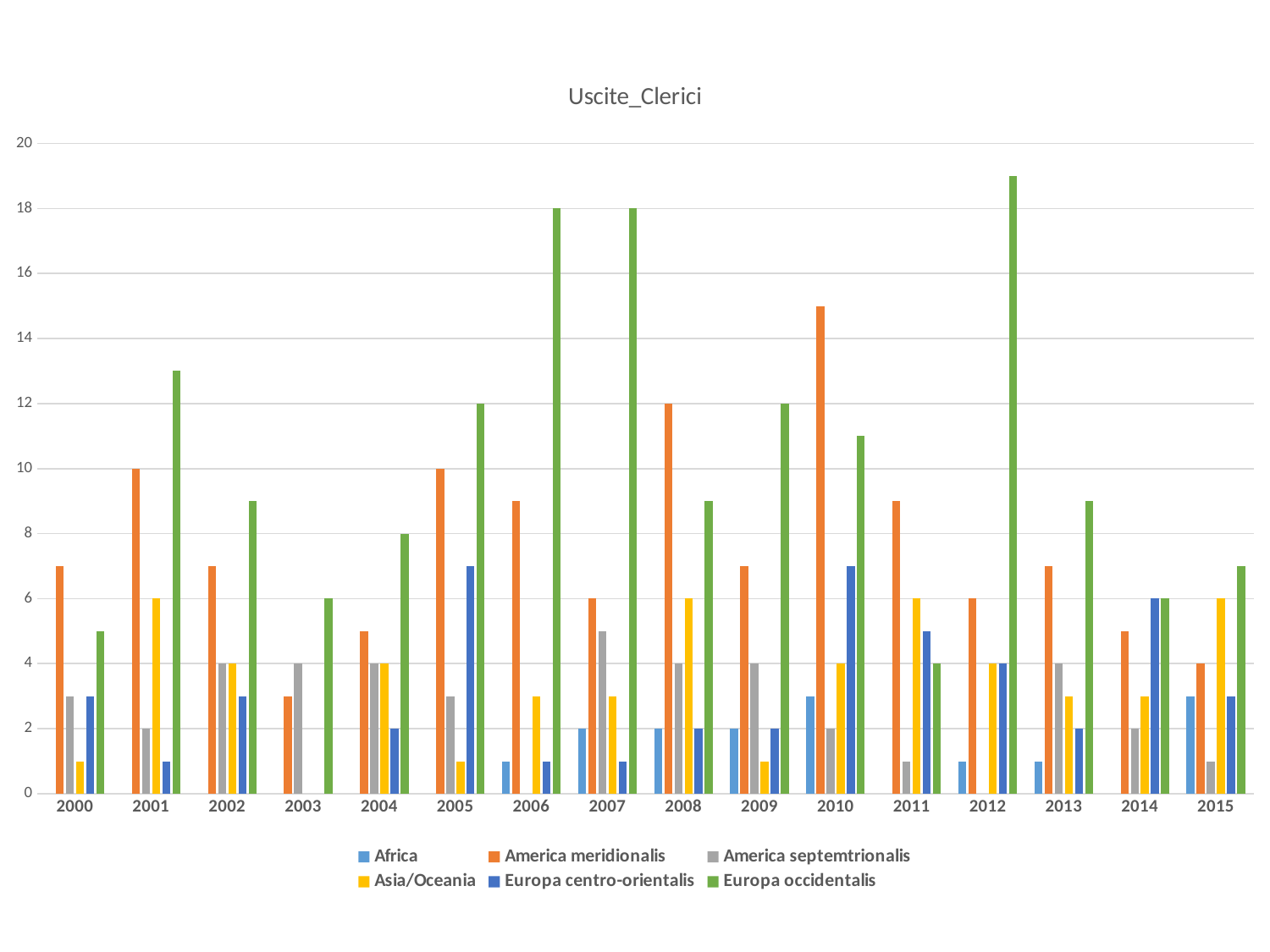
In which year is the Europa occidentalis bar highest? 2012 What is the value for America meridionalis in 2001? 10 Is the value for America meridionalis in 2010 greater or less than 14? greater In 2010, which is larger: America meridionalis or Europa occidentalis? America meridionalis What is the value for America meridionalis in 2008? 12 Is the value for Europa occidentalis in 2012 greater or less than 18? greater How many years are shown on the x axis? 16 What is the value for Europa occidentalis in 2006? 18 What is the difference between the Europa occidentalis values in 2006 and 2005? 6 How many series does the legend list? 6 What is the title of the chart? Uscite_Clerici What kind of chart is shown on the slide? bar chart